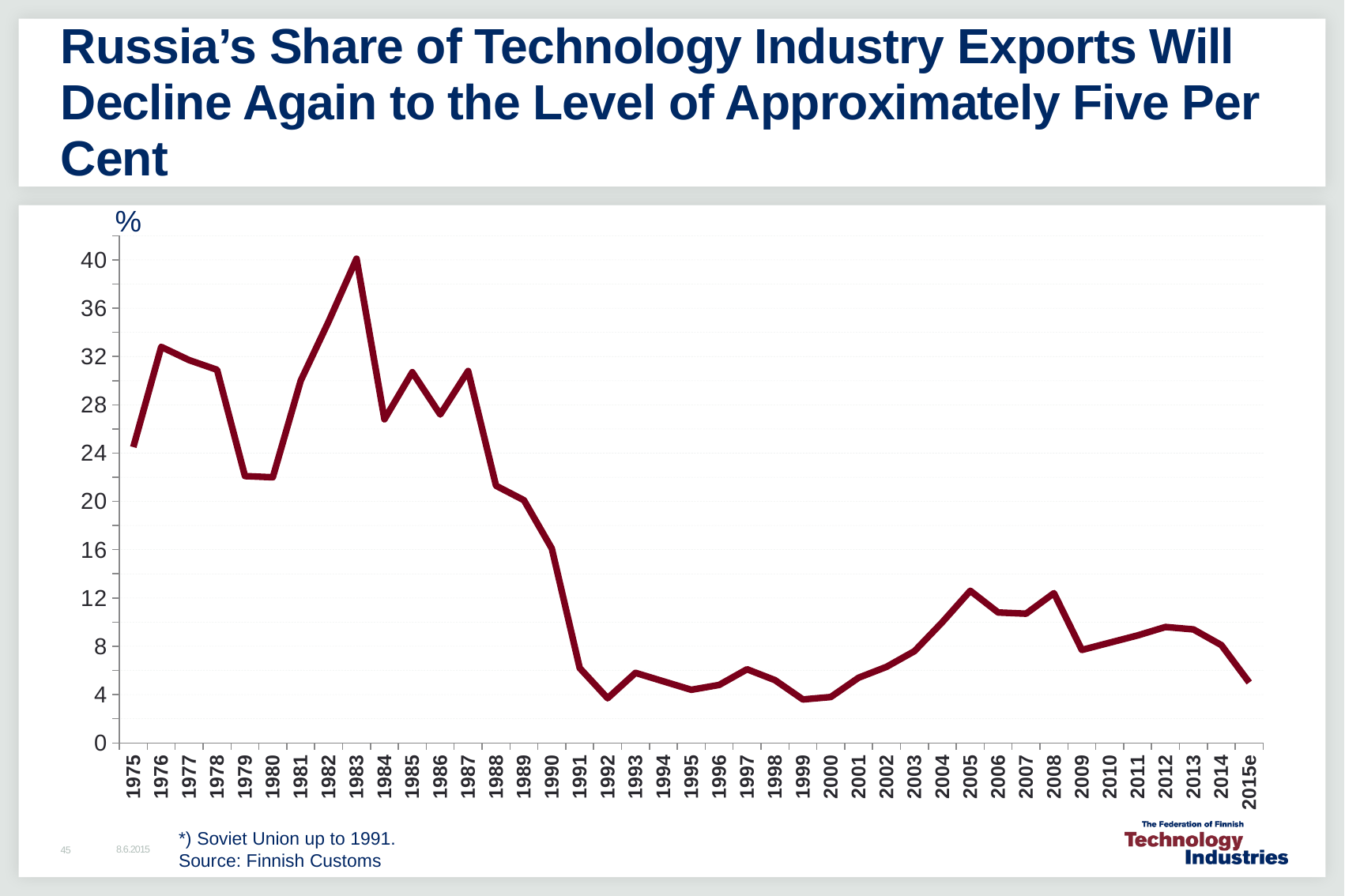
What unit is shown at the top of the y axis? % Is the value for 1979 greater or less than 24? less What kind of chart is shown on the slide? line chart Is the value for 1990 greater or less than 20? less Is the value for 1983 greater or less than 36? greater Which year has the highest value on the chart? 1983 Do the values rise or fall between 1987 and 1992? fall Which year has the larger value, 1990 or 1991? 1990 Which year has the larger value, 1976 or 1983? 1983 How many years are shown on the x axis? 41